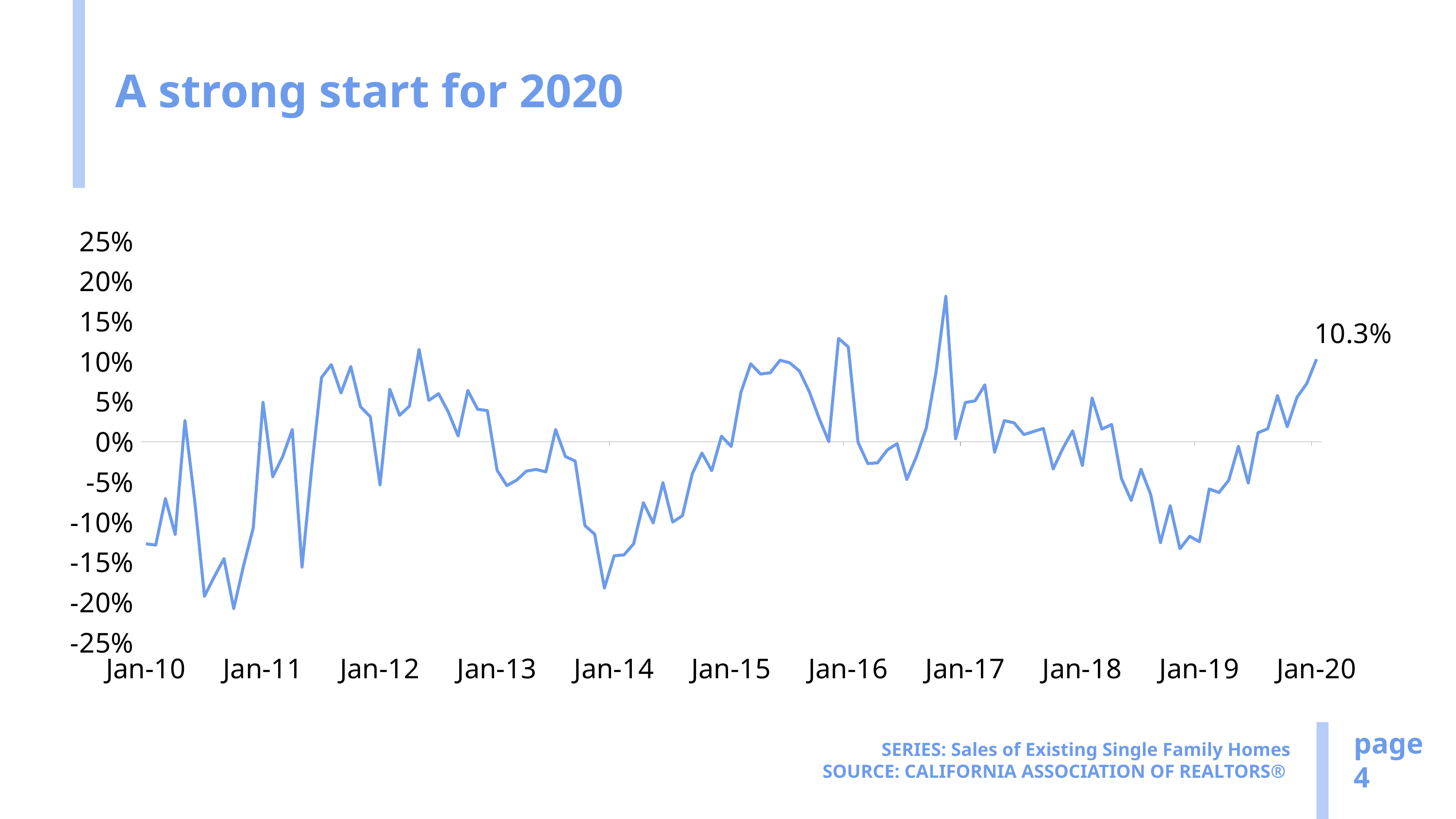
Which is larger, the value at Jan-17 or the value at Jan-14? Jan-17 Between Jan-19 and Jan-20, does the line generally rise or fall? rise What kind of chart is shown on the slide? line chart What value is labelled at the end of the line for Jan-20? 10.3% Is the value at Jan-10 greater or less than -10%? less Is the highest point on the line greater or less than 15%? greater How many year labels are shown on the x axis? 11 Is the value at Jan-19 greater or less than -10%? less What is the title of the slide? A strong start for 2020 Which is larger, the value at Jan-20 or the value at Jan-10? Jan-20